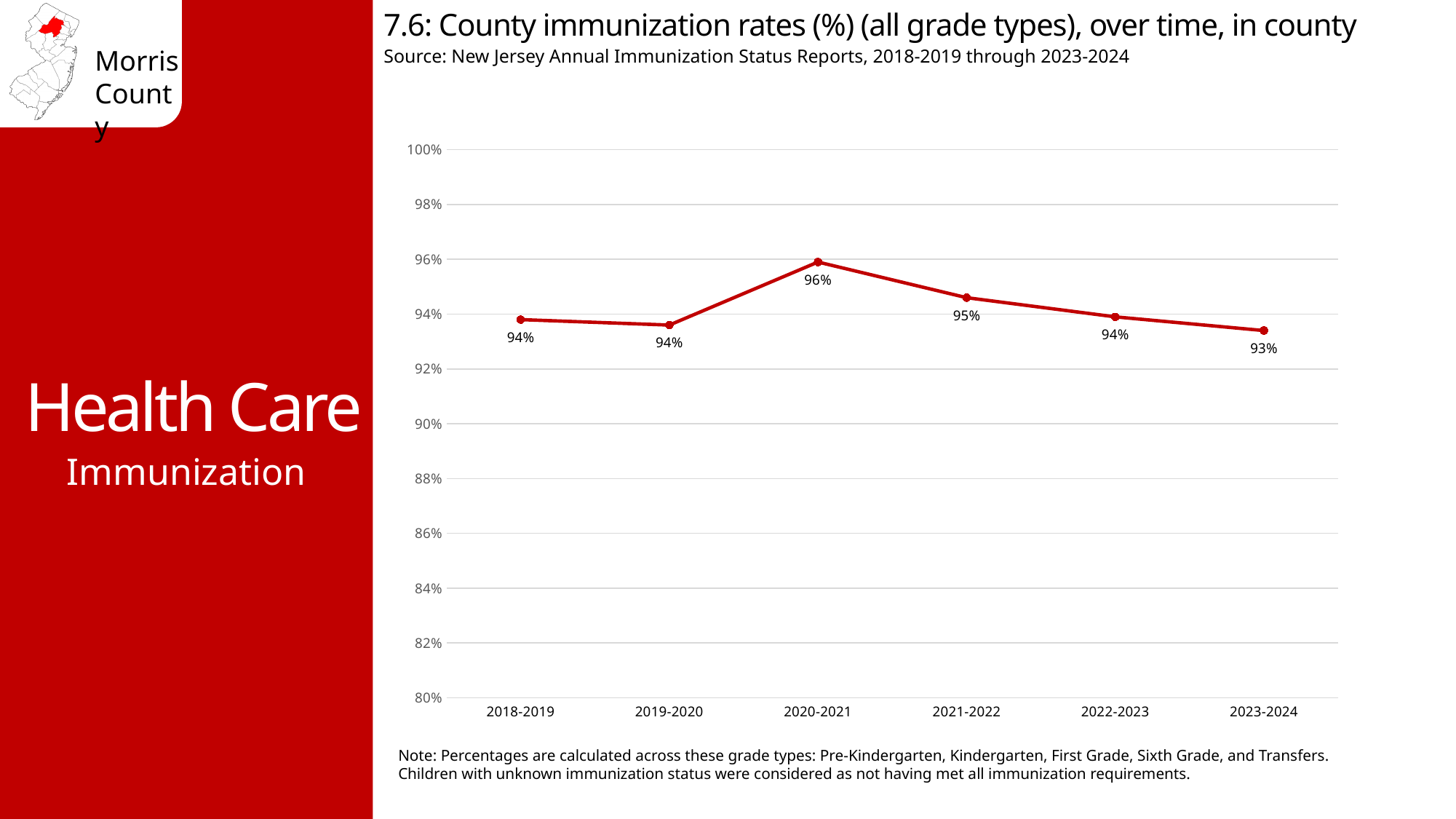
What was the county immunization rate in 2020-2021? 96% What was the county immunization rate in 2018-2019? 94% Which is larger, the immunization rate in 2020-2021 or in 2023-2024? 2020-2021 What type of chart is shown on the slide? Line chart Which school year had the lowest labeled immunization rate? 2023-2024 What was the county immunization rate in 2021-2022? 95% What is the source cited for the chart data? New Jersey Annual Immunization Status Reports, 2018-2019 through 2023-2024 Which school year had the highest immunization rate? 2020-2021 How many school years are plotted on the chart? 6 Does the immunization rate rise or fall from 2020-2021 to 2023-2024? Fall What is the difference in percentage points between the 2020-2021 rate and the 2023-2024 rate? 3 percentage points What was the county immunization rate in 2023-2024? 93%